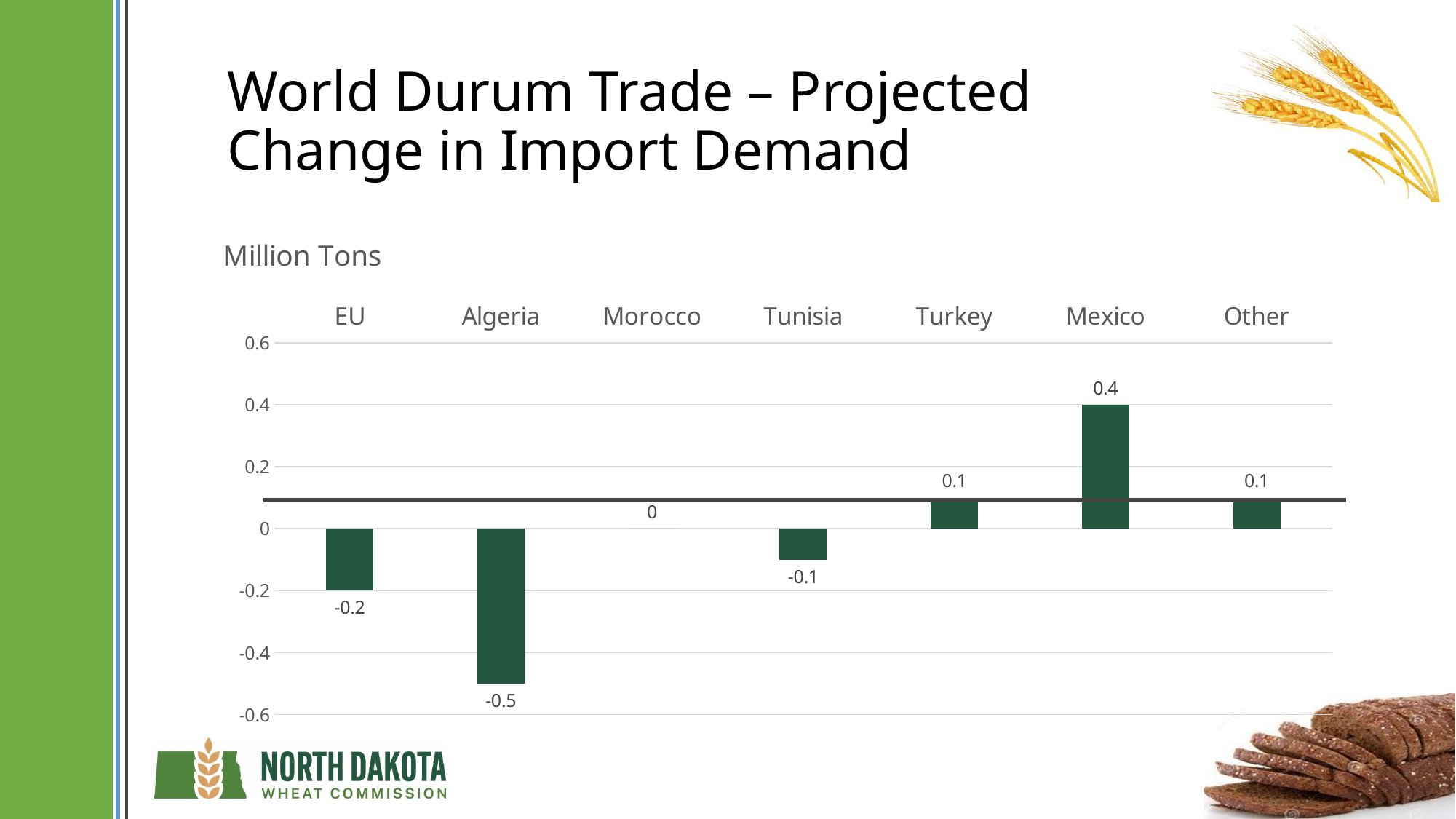
Which is larger, the value for Turkey or the value for Tunisia? Turkey Which category has the highest projected change in import demand? Mexico What kind of chart is shown on the slide? Bar chart What is the difference between the values for Mexico and Algeria? 0.9 What unit is the chart measured in, according to the label above the chart? Million Tons What is the projected change in import demand for Morocco? 0 What is the projected change in import demand for Algeria? -0.5 Which category has the lowest projected change in import demand? Algeria What is the projected change in import demand for the EU? -0.2 What is the difference between the values for Tunisia and the EU? 0.1 How many categories are shown on the chart? 7 What is the projected change in import demand for Mexico? 0.4